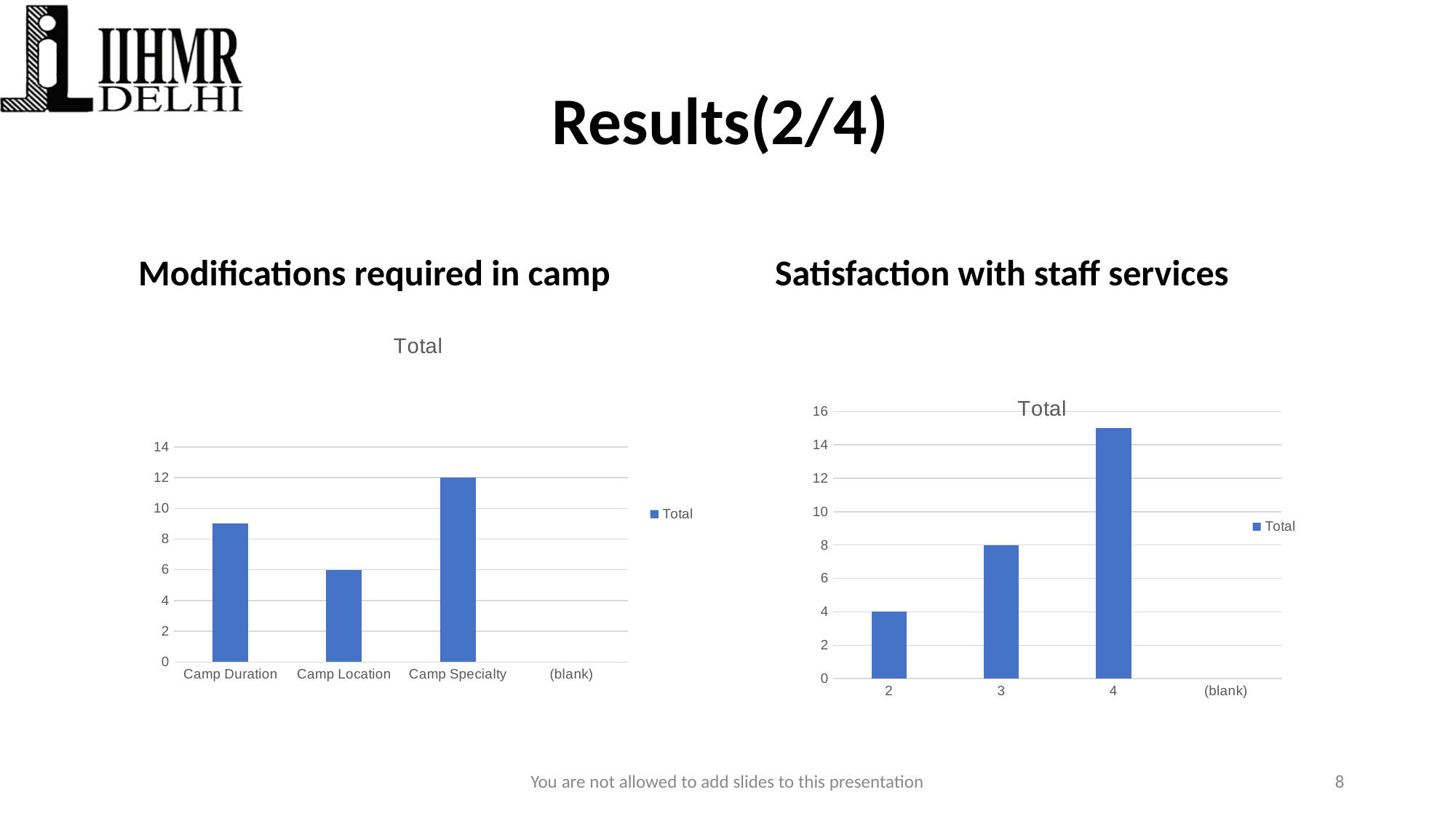
In the 'Satisfaction with staff services' chart, do the values rise or fall from category 2 to category 4? rise In the 'Satisfaction with staff services' chart, is the value for category 4 greater or less than 14? greater In the 'Modifications required in camp' chart, is the value for Camp Duration greater or less than 8? greater In the 'Modifications required in camp' chart, what is the value for Camp Specialty? 12 In the 'Satisfaction with staff services' chart, what is the value for category 3? 8 In the 'Modifications required in camp' chart, what is the difference between the values for Camp Specialty and Camp Location? 6 In the 'Modifications required in camp' chart, which category has the highest value? Camp Specialty In the 'Satisfaction with staff services' chart, what is the value for category 2? 4 In the 'Modifications required in camp' chart, what is the value for Camp Location? 6 In the 'Satisfaction with staff services' chart, what is the difference between the values for category 3 and category 2? 4 In the 'Modifications required in camp' chart, which is larger: Camp Duration or Camp Location? Camp Duration What kind of chart is the 'Satisfaction with staff services' chart? bar chart